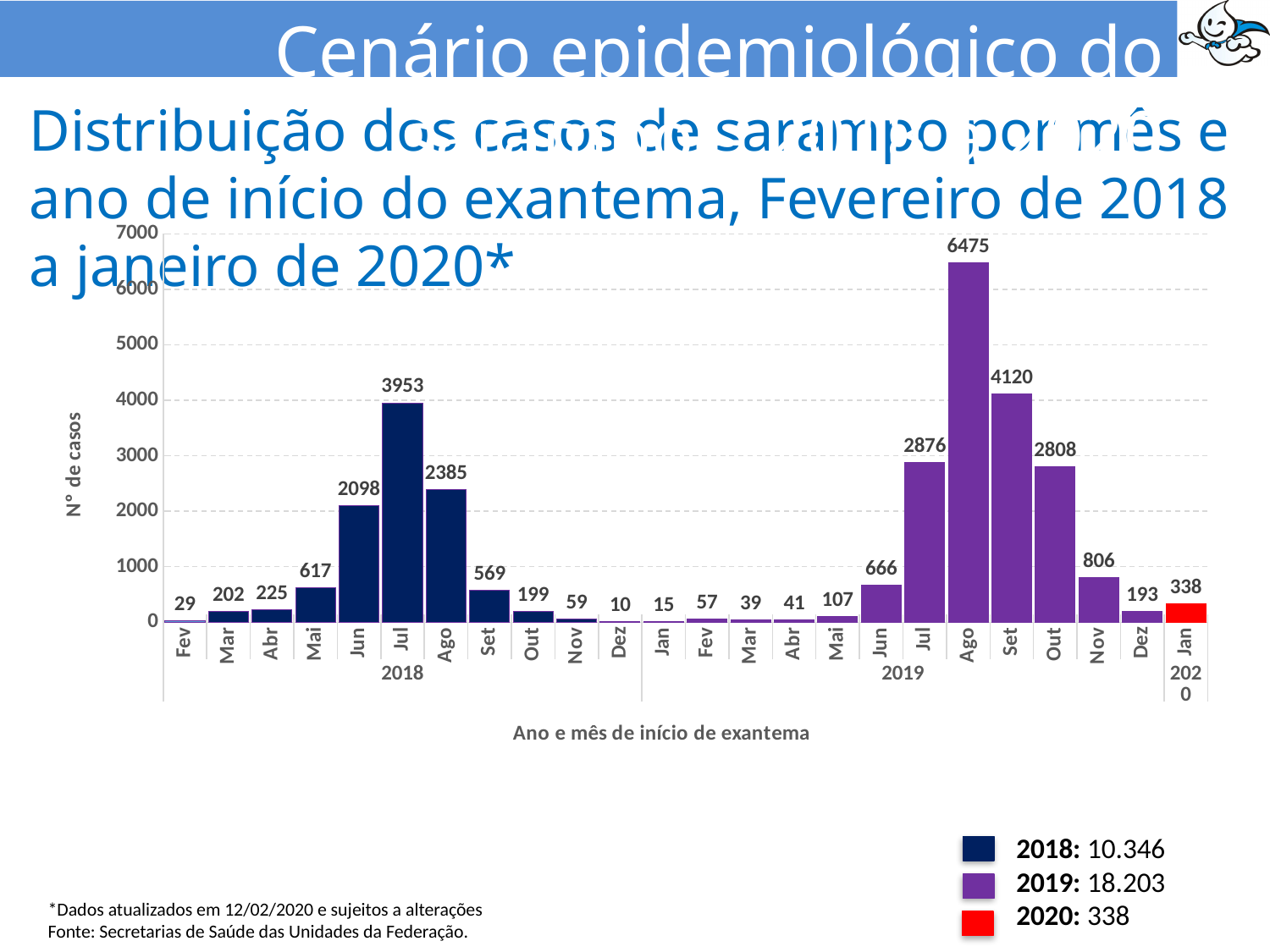
Which month has the lowest number of cases in the chart? Dez 2018 Which month has the highest number of cases in the chart? Ago 2019 What is the label of the y axis of the chart? Nº de casos How many cases are shown for August 2019 (Ago 2019)? 6475 How many monthly bars are plotted in the chart? 24 Which is larger, the value for September 2019 (Set 2019) or the value for August 2018 (Ago 2018)? Set 2019 What is the difference in cases between August 2019 (6475) and July 2018 (3953)? 2522 What kind of chart is shown on the slide? bar chart What is the value for July 2018 (Jul 2018)? 3953 What is the value for January 2020 (Jan 2020)? 338 Do the values rise or fall from May 2019 (Mai) to August 2019 (Ago)? rise Is the value for October 2019 (Out 2019) greater or less than 2000? greater